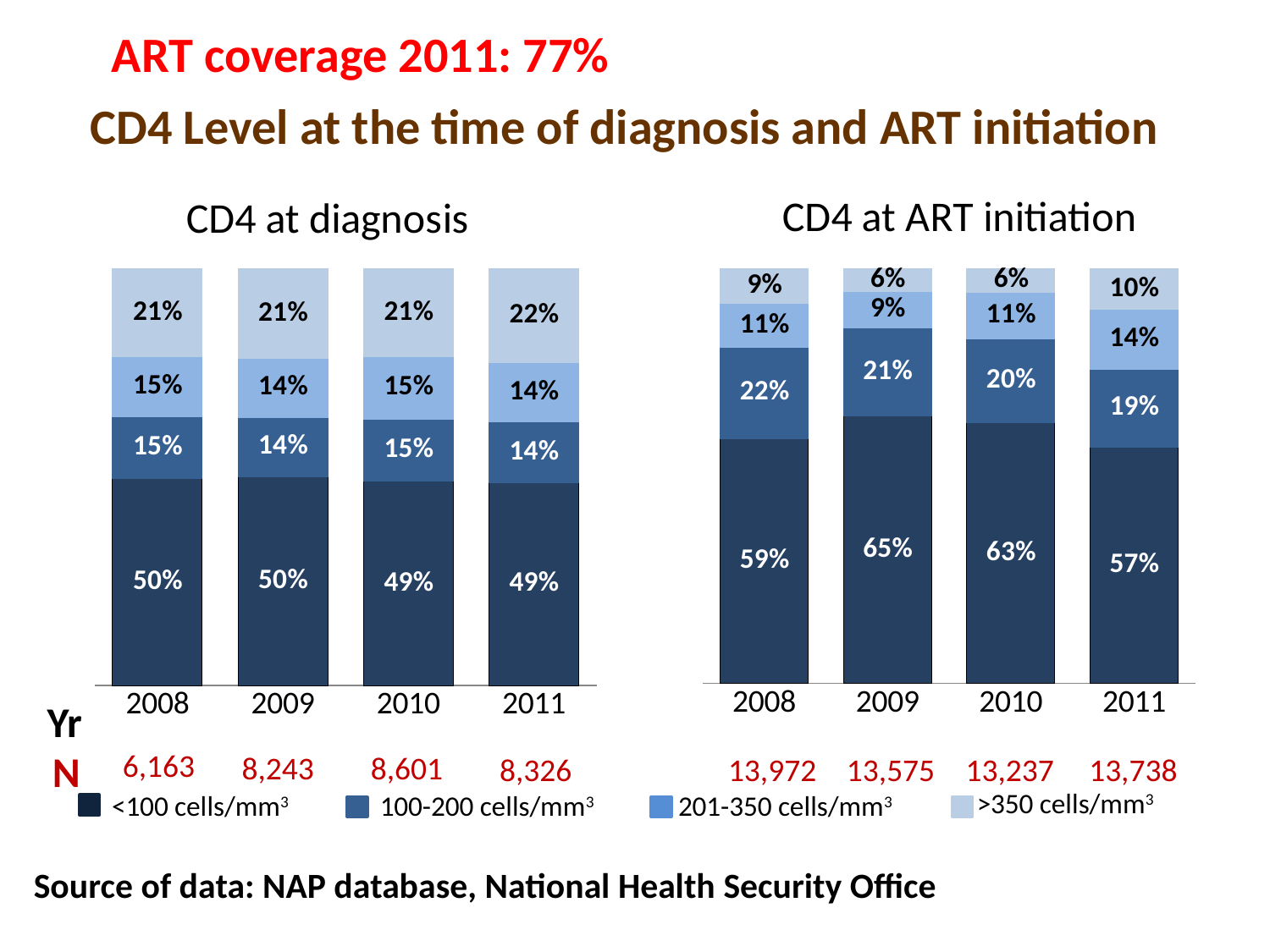
In the 'CD4 at diagnosis' chart, what percentage of patients had <100 cells/mm3 in 2008? 50% What is the N value shown for 2008 in the 'CD4 at ART initiation' chart? 13,972 How many years are shown on the x axis of the 'CD4 at diagnosis' chart? 4 How many CD4 level categories does the legend list? 4 In the 'CD4 at diagnosis' chart, what percentage of patients had >350 cells/mm3 in 2011? 22% In the 'CD4 at ART initiation' chart, which year has the highest share of patients with <100 cells/mm3? 2009 Which is larger: the <100 cells/mm3 share in 2010 in the 'CD4 at diagnosis' chart or in the 'CD4 at ART initiation' chart? CD4 at ART initiation In the 'CD4 at ART initiation' chart, which year has the lowest share of patients with <100 cells/mm3? 2011 In the 'CD4 at ART initiation' chart, what percentage of patients had <100 cells/mm3 in 2009? 65% In the 'CD4 at ART initiation' chart, what is the difference between the <100 cells/mm3 share in 2009 and in 2011? 8% What type of chart is 'CD4 at ART initiation'? Stacked bar chart In the 'CD4 at ART initiation' chart, what percentage of patients had >350 cells/mm3 in 2011? 10%